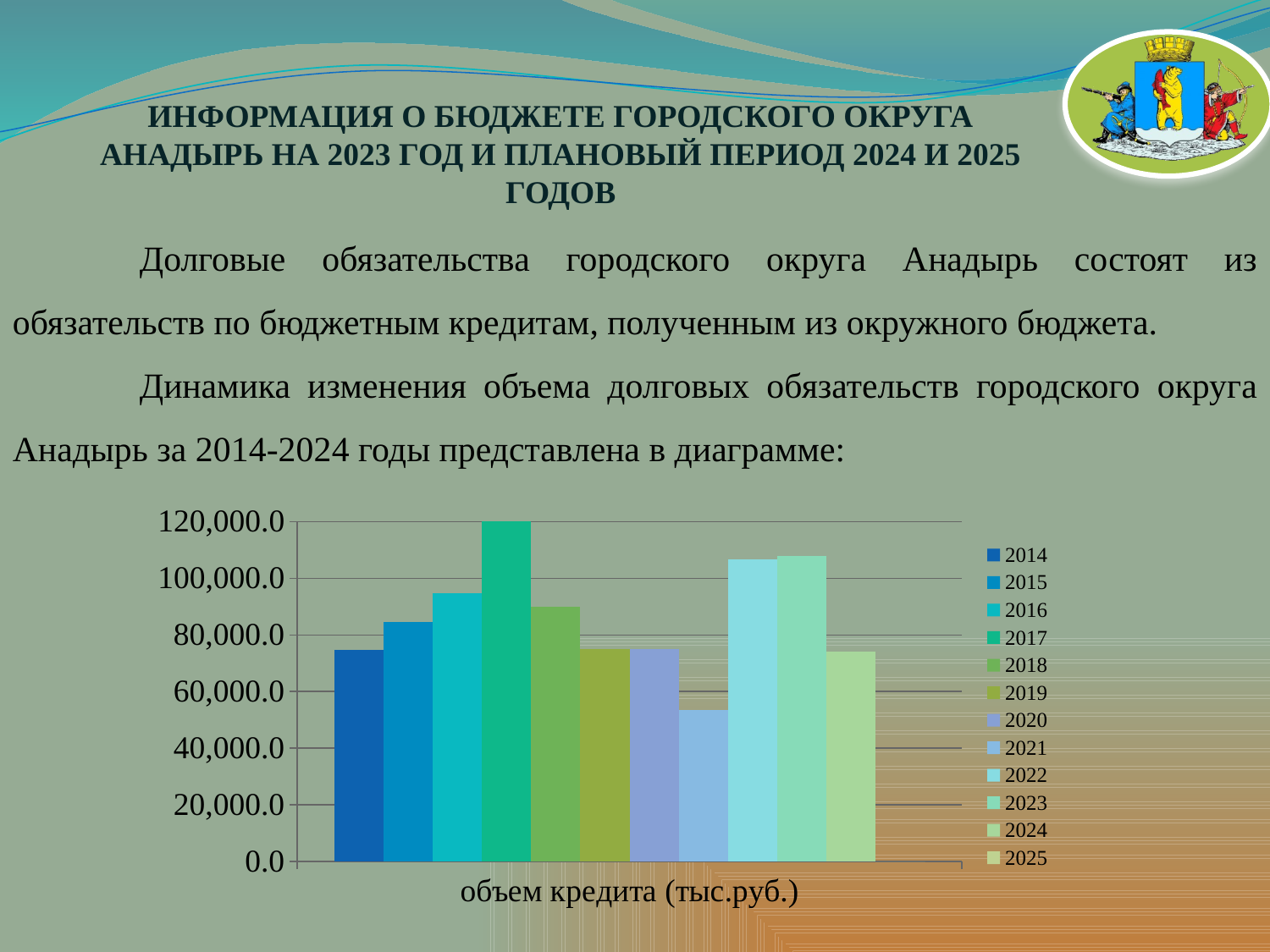
Is the value for 2021 greater or less than 60,000.0? less Which year has the highest bar in the chart? 2017 Is the value for 2017 greater or less than 100,000.0? greater What is the label shown on the horizontal axis of the chart? объем кредита (тыс.руб.) Is the value for 2016 greater or less than 80,000.0? greater What kind of chart is shown on the slide? bar chart Which is larger, the value for 2016 or the value for 2015? 2016 Which is larger, the value for 2018 or the value for 2019? 2018 How many series does the legend list? 12